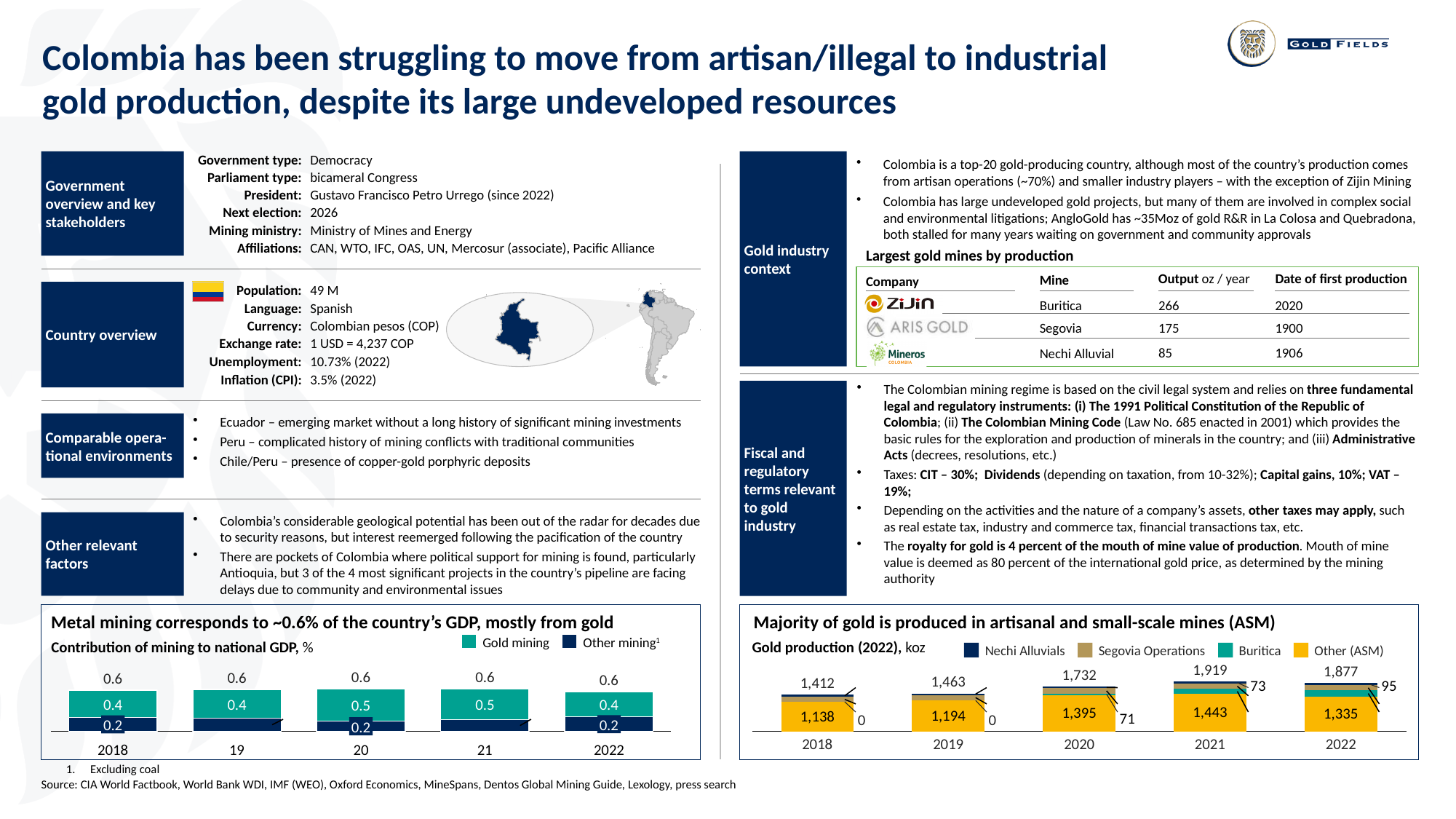
How many years are shown on the x axis of the 'Contribution of mining to national GDP, %' chart? 5 In the 'Gold production (2022), koz' chart, which year has the lowest total gold production? 2018 In the 'Gold production (2022), koz' chart, which year has the highest total gold production? 2021 How many series does the legend of the 'Gold production (2022), koz' chart list? 4 What kind of chart is the 'Contribution of mining to national GDP, %' chart? bar chart In the 'Gold production (2022), koz' chart, what is the Other (ASM) value for 2020? 1,395 In the 'Contribution of mining to national GDP, %' chart, what is the total contribution of mining for 2018? 0.6 In the 'Contribution of mining to national GDP, %' chart, what is the Gold mining value for 2020? 0.5 In the 'Gold production (2022), koz' chart, what is the difference between the total for 2021 and the total for 2020? 187 In the 'Gold production (2022), koz' chart, what is the total gold production shown for 2021? 1,919 In the 'Gold production (2022), koz' chart, which is larger: the Other (ASM) value for 2019 or for 2022? 2022